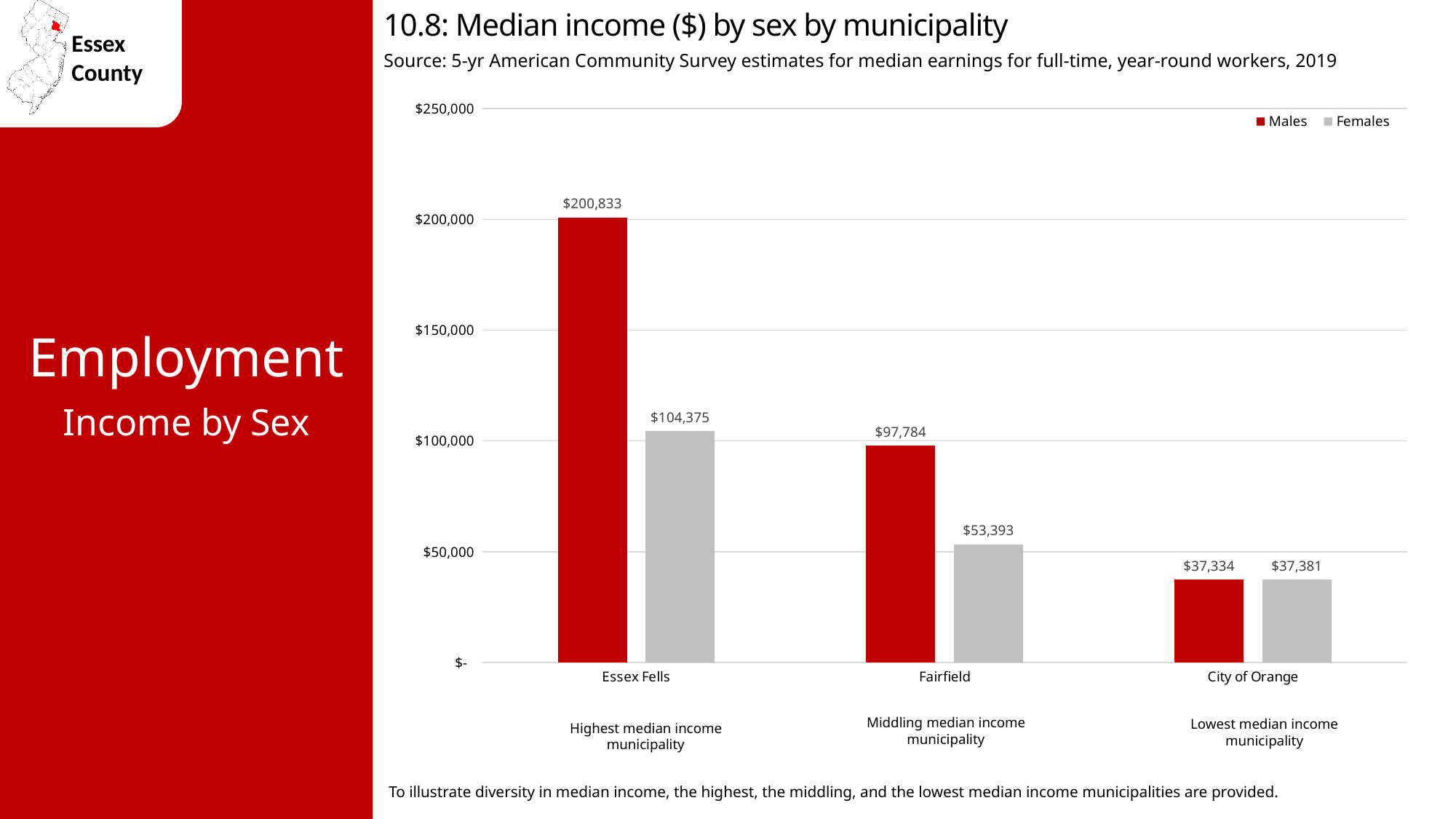
Which is larger in Fairfield, the median income for males or for females? Males What is the median income for males in Essex Fells? $200,833 What kind of chart is shown on the slide? Bar chart Which municipality has the lowest median income for females? City of Orange Is the median income for females in Essex Fells greater or less than $100,000? greater How many municipalities are shown on the chart? 3 What is the difference between male and female median income in Fairfield? $44,391 Which municipality has the highest median income for males? Essex Fells What is the median income for females in City of Orange? $37,381 What is the median income for females in Fairfield? $53,393 What is the difference between male and female median income in Essex Fells? $96,458 How many series does the legend list? 2